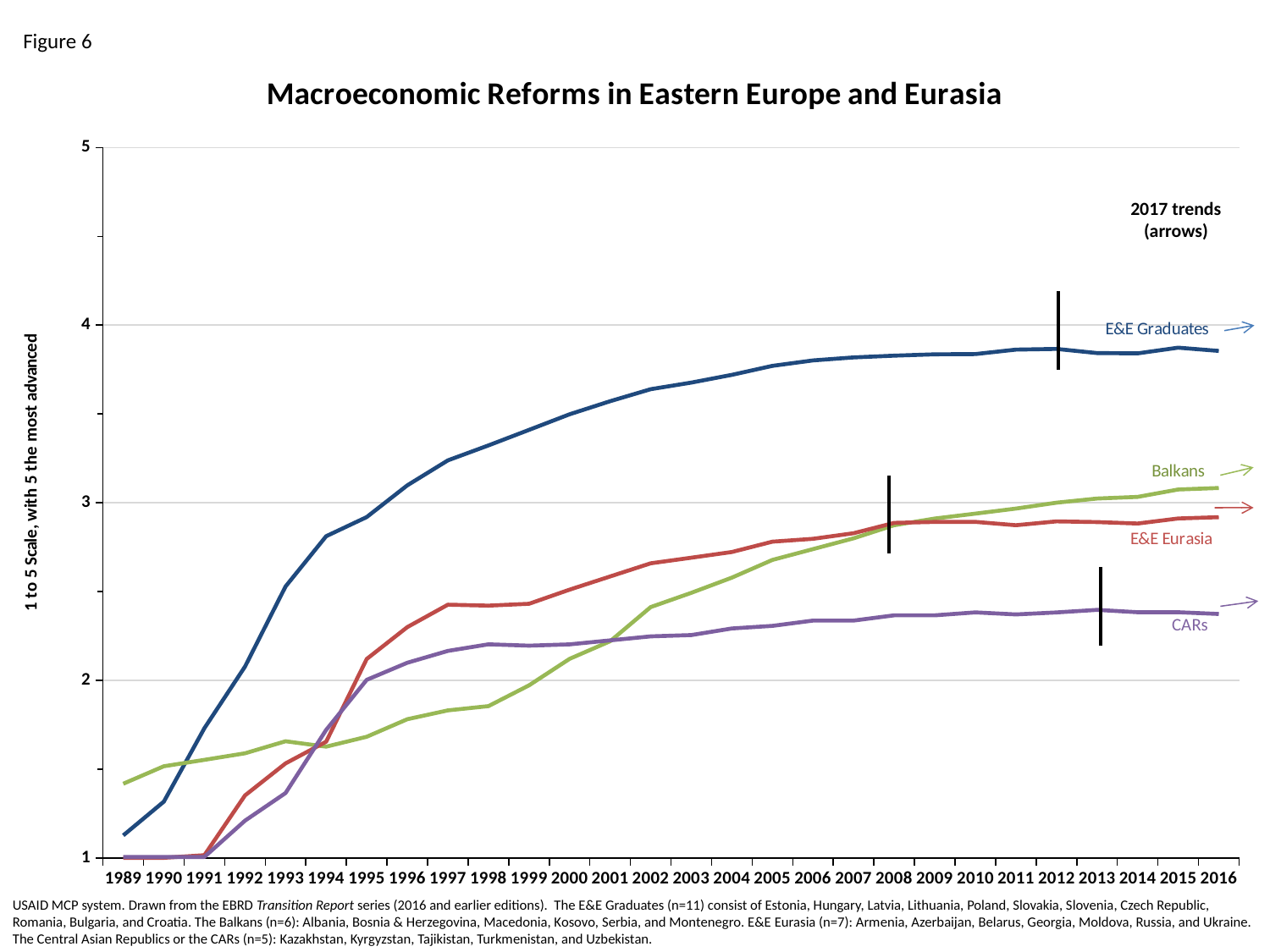
How many years are shown along the x axis of the chart? 28 Does the E&E Graduates line generally rise or fall from 1989 to 2016? rise Is the value for E&E Graduates in 2016 greater or less than 4? less What kind of chart is shown on the slide? line chart Is the value for CARs in 2016 greater or less than 3? less Which series has the lowest value in 2016? CARs How many series (lines) are plotted on the chart? 4 In 2016, which is higher: Balkans or E&E Eurasia? Balkans Is the value for E&E Graduates in 1997 greater or less than 3? greater Which series has the highest value in 2016? E&E Graduates What is the title of the chart? Macroeconomic Reforms in Eastern Europe and Eurasia Which series has the highest value in 1989? Balkans